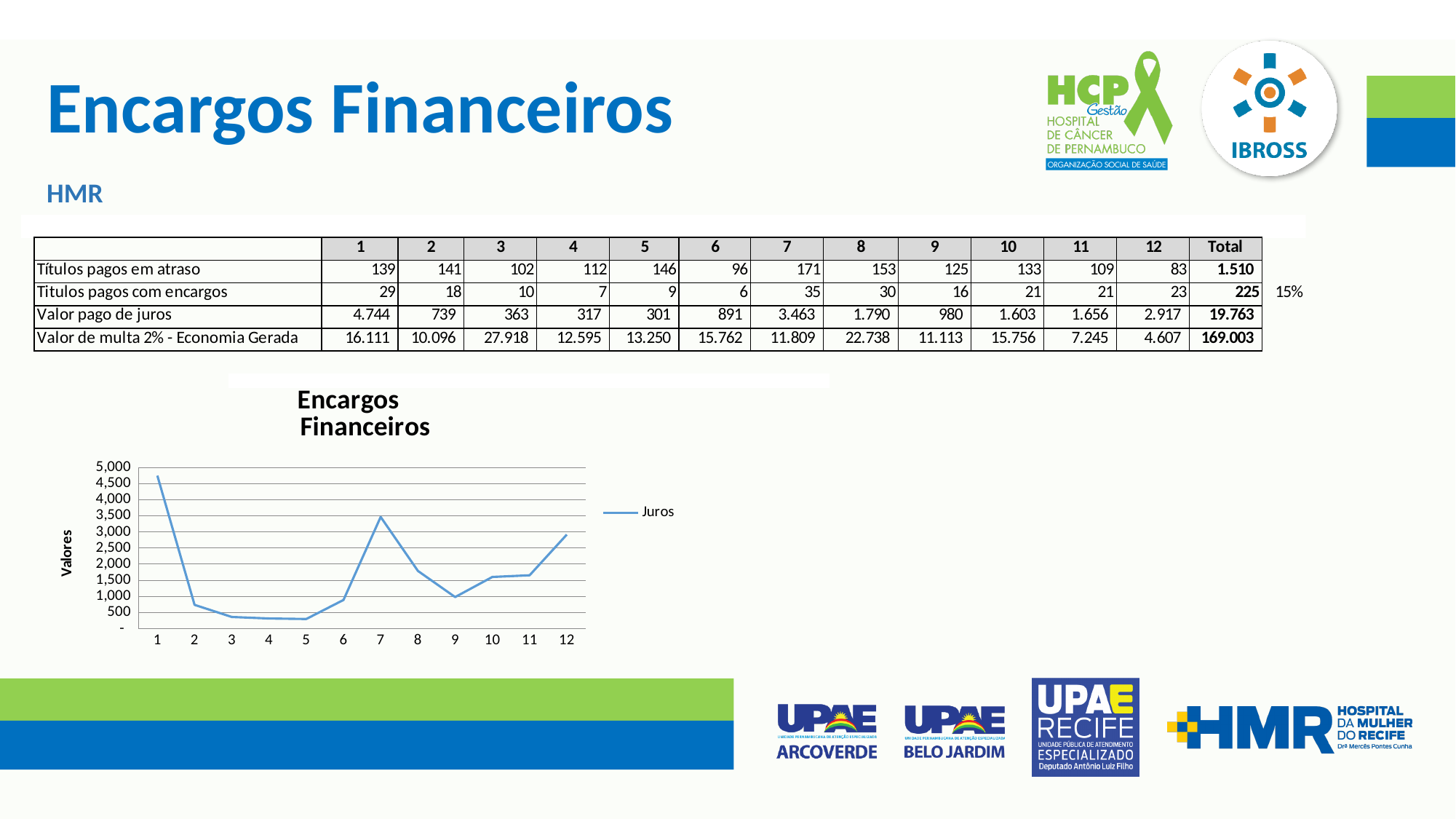
Is the Juros value at x = 6 greater or less than 1,000? less What is the title of the chart? Encargos Financeiros How many series does the chart legend list? 1 How many points are plotted along the x axis of the chart? 12 Is the Juros value at x = 12 greater or less than 3,000? less At which x-axis value does the Juros line reach its highest point? 1 Does the Juros line rise or fall from x = 1 to x = 5? fall Is the Juros value at x = 7 greater or less than 3,000? greater What kind of chart is shown on the slide? line chart What is the name of the series shown in the chart legend? Juros Which is larger on the chart, the Juros value at x = 7 or at x = 12? x = 7